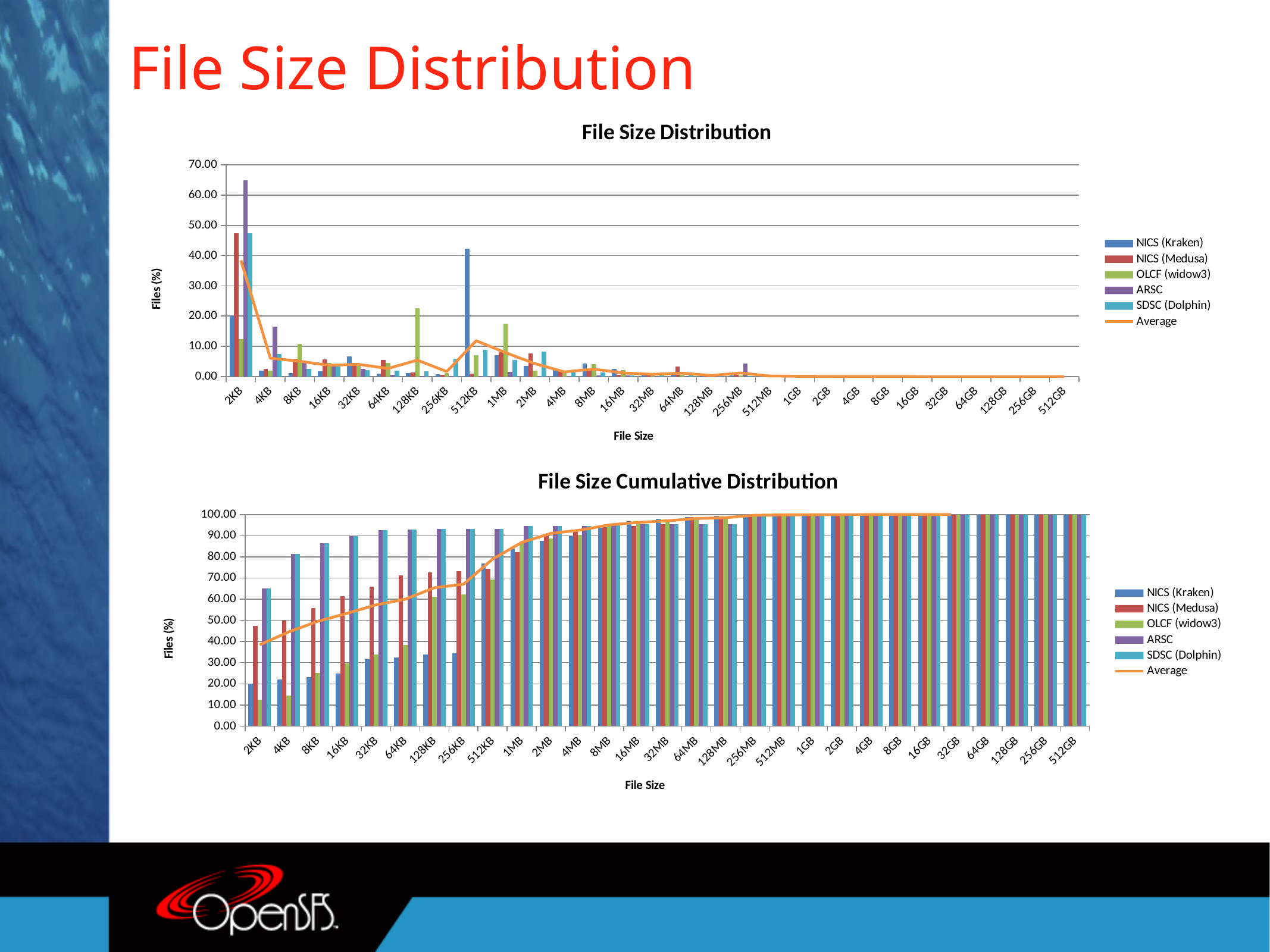
In the bottom "File Size Cumulative Distribution" chart, is the value for NICS (Kraken) at 2KB greater or less than 30.00? less In the top "File Size Distribution" chart, is the value for ARSC at 2KB greater or less than 60.00? greater In the bottom "File Size Cumulative Distribution" chart, is the value for ARSC at 4KB greater or less than 70.00? greater What type of chart is the top chart titled "File Size Distribution"? bar chart with a line In the top "File Size Distribution" chart, which is larger at 2KB: NICS (Kraken) or NICS (Medusa)? NICS (Medusa) In the bottom "File Size Cumulative Distribution" chart, do the values for the Average line rise or fall as file size increases along the x axis? rise How many series does the legend of the top "File Size Distribution" chart list? 6 What is the label of the y axis on the bottom "File Size Cumulative Distribution" chart? Files (%) In the top "File Size Distribution" chart, which series has the highest bar at 2KB? ARSC How many file size categories are shown on the x axis of the bottom "File Size Cumulative Distribution" chart? 29